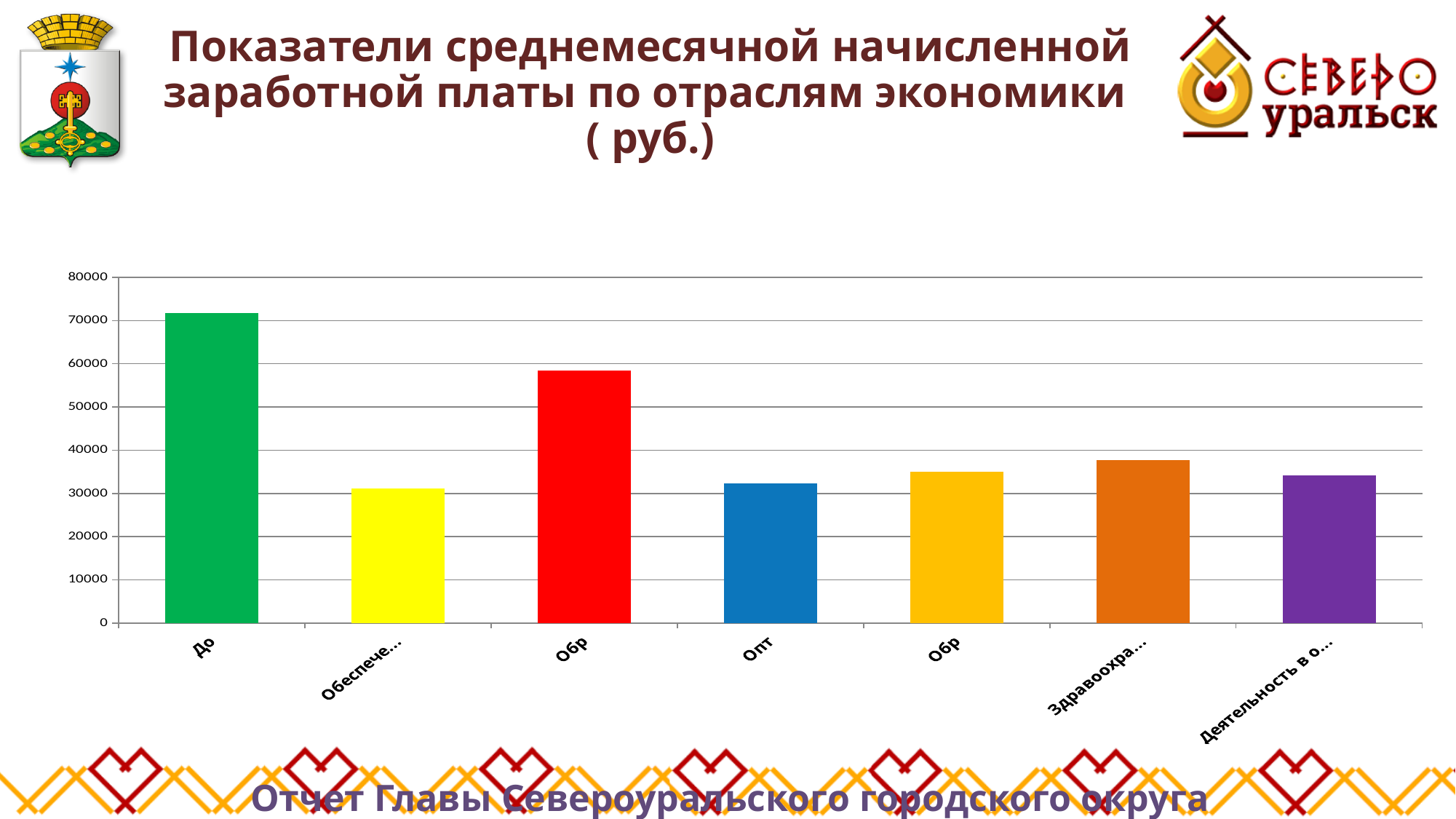
Is the value of the third (red) bar greater or less than 50000? greater What colour is the bar for the category "До"? green Which category has the highest value in the chart? До Is the value for the category "Деятельность в о..." greater or less than 30000? greater Is the value for the category "До" greater or less than 60000? greater How many bars (categories) does the chart show? 7 Which is larger, the value for "Здравоохра..." or the value for "Опт"? Здравоохра... What kind of chart is shown on the slide? bar chart What is the unit given in the chart title? руб. Which is larger, the value for "До" or the value for "Опт"? До